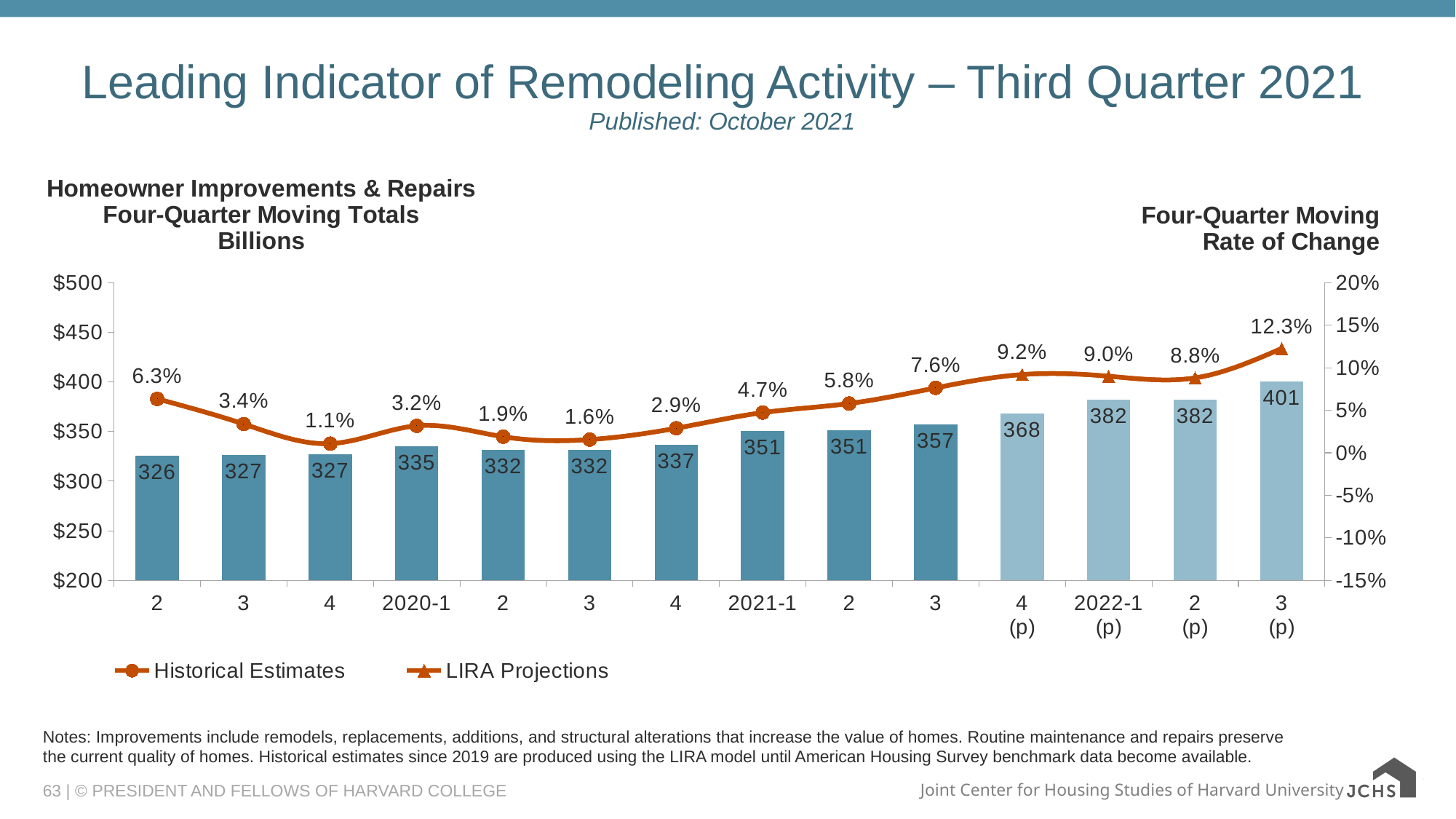
What are the two series named in the legend? Historical Estimates and LIRA Projections Which quarter has the lowest four-quarter moving rate of change on the line? 4 (the quarter before 2020-1) Which quarter has the highest four-quarter moving rate of change on the line? 3 (p) How many quarters (bars) are plotted on the chart? 14 What rate of change is labeled for 2022-1 (p)? 9.0% Do the bar values generally rise or fall from left to right across the chart? rise What is the four-quarter moving total (in billions) shown on the bar for 2021-1? 351 What four-quarter moving rate of change is labeled for 2020-1? 3.2% What is the difference between the bar values for 3 (p) and 2022-1 (p)? 19 What is the value of the bar for 3 (p), the last projected quarter? 401 Which is larger, the bar value for 2021-1 or the bar value for 2020-1? 2021-1 How many series does the legend list? 2